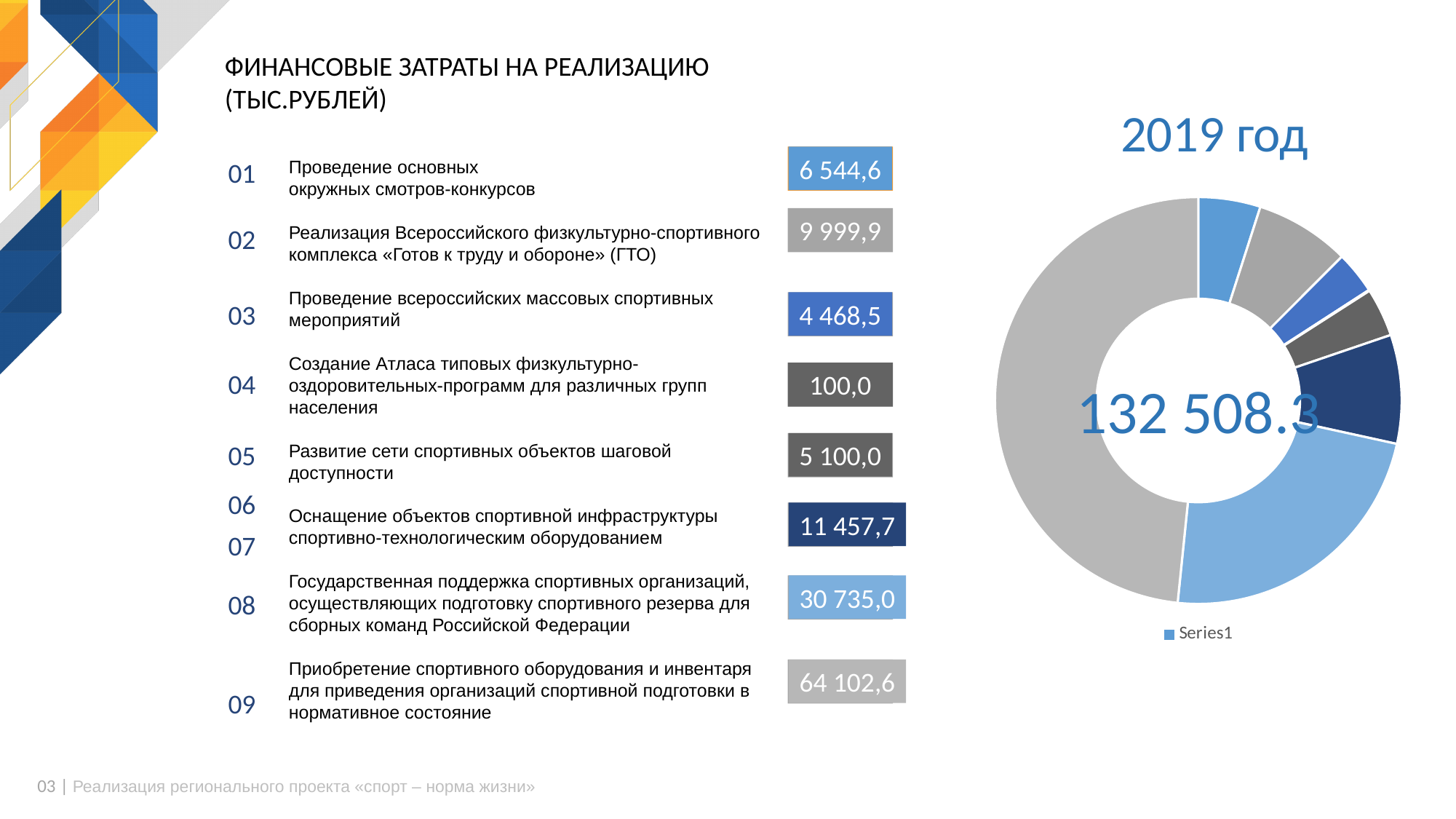
What is the legend entry shown below the doughnut chart? Series1 Which is larger: the value for Государственная поддержка спортивных организаций or for Оснащение объектов спортивной инфраструктуры? Государственная поддержка спортивных организаций (30 735,0) Which item has the largest value in the 2019 breakdown? 09 Приобретение спортивного оборудования и инвентаря (64 102,6) What is the title of the doughnut chart? 2019 год Which item has the smallest value in the 2019 breakdown? 04 Создание Атласа типовых физкультурно-оздоровительных программ (100,0) What is the difference between the value for item 02 (9 999,9) and item 01 (6 544,6)? 3 455,3 What is the difference between the value for item 09 (64 102,6) and item 08 (30 735,0)? 33 367,6 What is the value for item 03, Проведение всероссийских массовых спортивных мероприятий? 4 468,5 What kind of chart is shown on the slide? doughnut chart What total value is printed in the centre of the doughnut chart? 132 508.3 How many series does the chart legend list? 1 What is the value (тыс. рублей) for item 09, Приобретение спортивного оборудования и инвентаря? 64 102,6